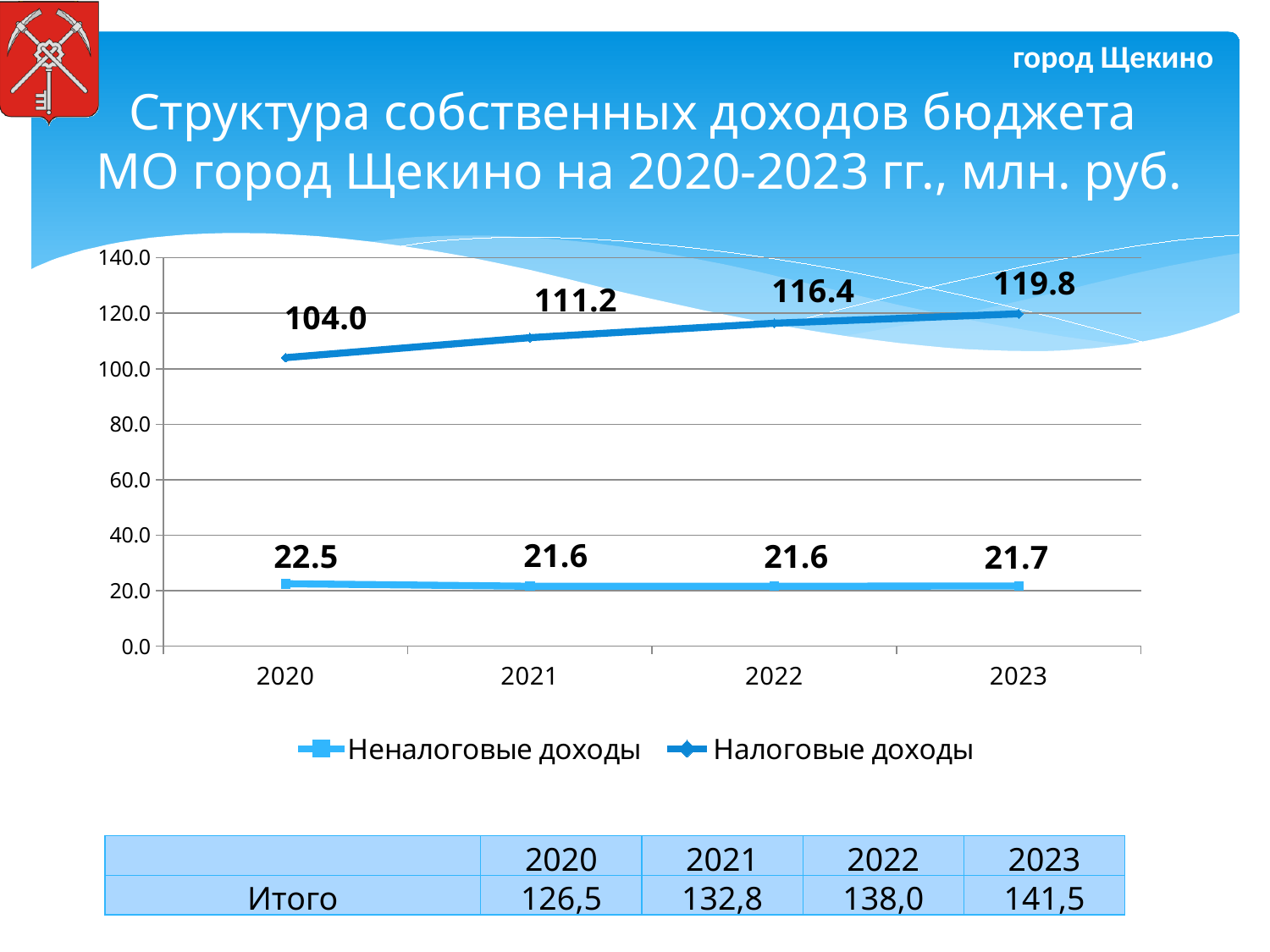
How many series does the legend list? 2 Which is larger: Налоговые доходы in 2021 or Налоговые доходы in 2022? 2022 What is the value of Налоговые доходы in 2022? 116.4 What is the difference between Налоговые доходы in 2023 and in 2020? 15.8 In which year is Неналоговые доходы highest? 2020 What is the value of Неналоговые доходы in 2023? 21.7 In which year is Налоговые доходы highest? 2023 Does Налоговые доходы rise or fall from 2020 to 2023? rise How many years are shown on the x axis? 4 What is the difference between Неналоговые доходы in 2020 and in 2021? 0.9 What is the value of Налоговые доходы in 2020? 104.0 What kind of chart is shown? line chart